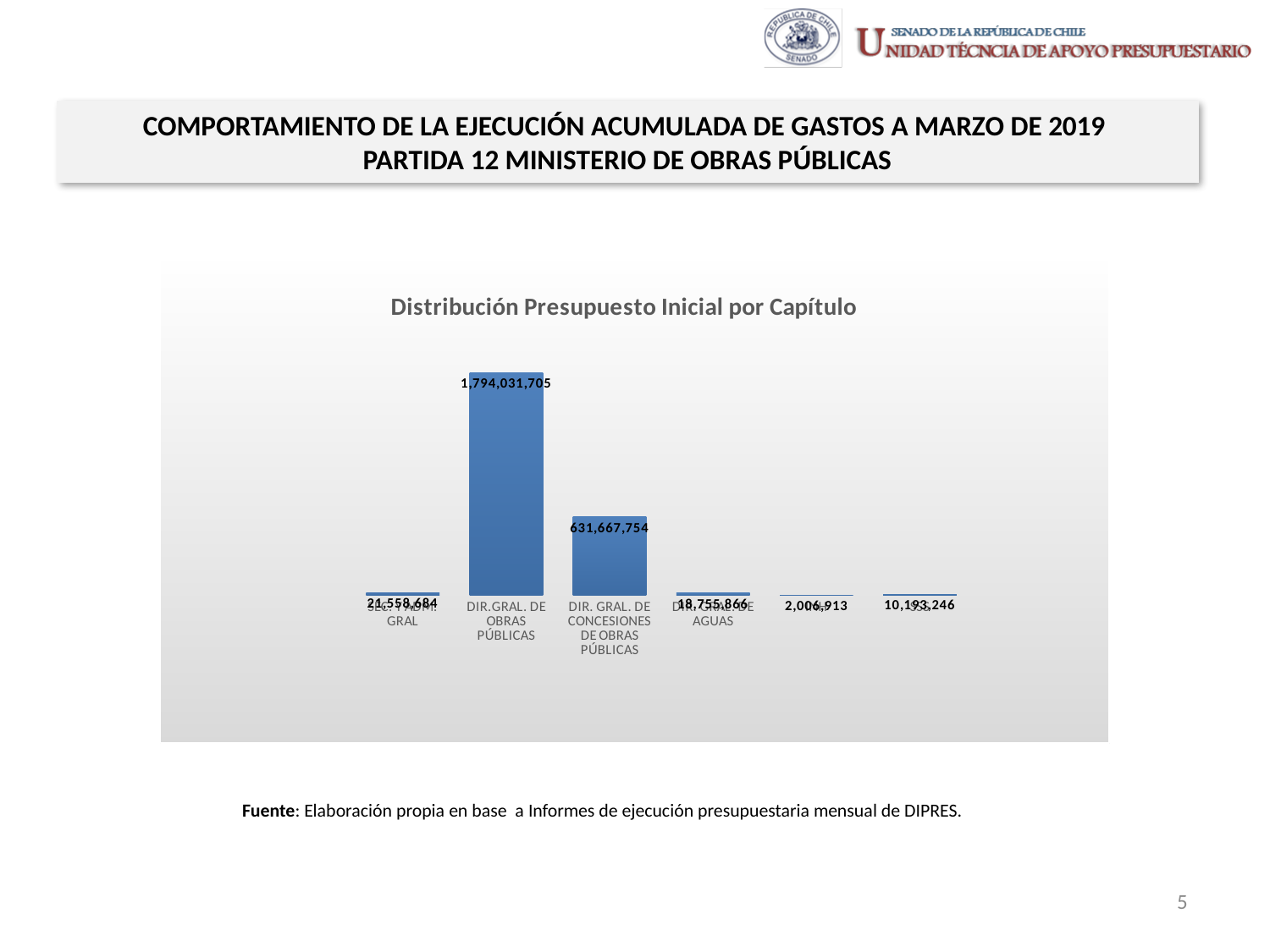
What is the title of the chart? Distribución Presupuesto Inicial por Capítulo Which category has the highest value in the chart? DIR.GRAL. DE OBRAS PÚBLICAS How many bars (categories) are plotted in the chart? 6 What is the largest value shown in the chart? 1,794,031,705 What is the smallest value shown in the chart? 2,006,913 Which is larger, the value for DIR.GRAL. DE OBRAS PÚBLICAS or the value for DIR. GRAL. DE CONCESIONES DE OBRAS PÚBLICAS? DIR.GRAL. DE OBRAS PÚBLICAS What kind of chart is shown on the slide? bar chart What is the value for DIR.GRAL. DE OBRAS PÚBLICAS? 1,794,031,705 What is the value for DIR. GRAL. DE CONCESIONES DE OBRAS PÚBLICAS? 631,667,754 What colour are the bars in the chart? blue What is the difference between the values for DIR.GRAL. DE OBRAS PÚBLICAS and DIR. GRAL. DE CONCESIONES DE OBRAS PÚBLICAS? 1,162,363,951